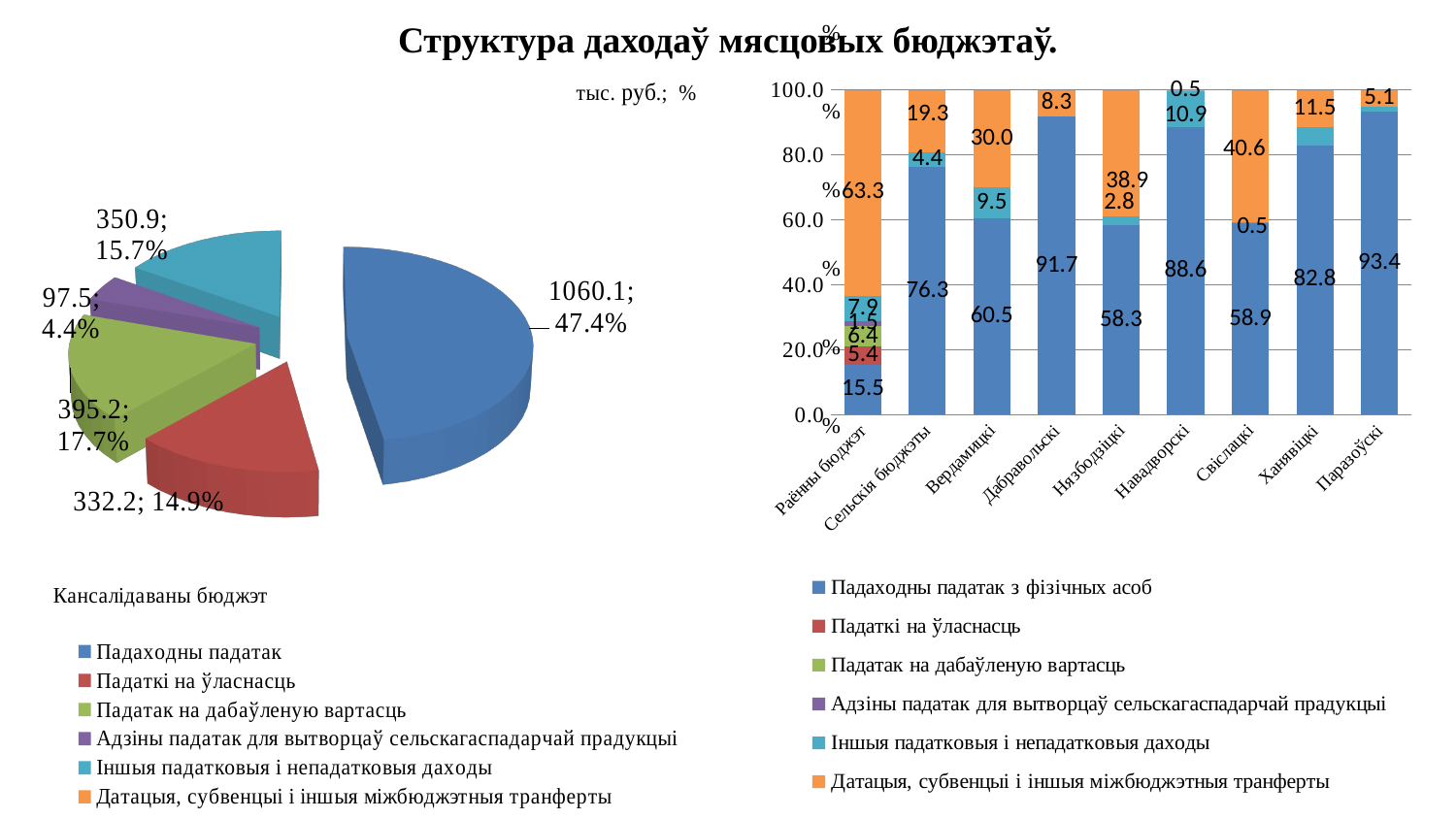
In the pie chart on the left, which slice is the smallest? Адзіны падатак для вытворцаў сельскагаспадарчай прадукцыі (97.5; 4.4%) In the stacked bar chart on the right, how many categories are shown on the x axis? 9 In the stacked bar chart on the right, what is the value of Датацыі, субвенцыі і іншыя міжбюджэтныя трансферты for Раённы бюджэт? 63.3 In the stacked bar chart on the right, what is the value of Падаходны падатак з фізічных асоб for Паразоўскі? 93.4 In the pie chart on the left, which is larger: the slice labelled 332.2 or the slice labelled 350.9? 350.9 What type of chart is shown on the right side of the slide? Stacked bar chart In the pie chart on the left, what value is shown for the blue slice (Падаходны падатак)? 1060.1; 47.4% In the pie chart on the left, which slice is the largest? Падаходны падатак (1060.1; 47.4%) In the stacked bar chart on the right, which category has the lowest value for Падаходны падатак з фізічных асоб? Раённы бюджэт In the stacked bar chart on the right, what is the difference between the Падаходны падатак з фізічных асоб values for Дабравольскі and Вердамицкі? 31.2 In the pie chart on the left, what share of the pie does the slice labelled 395.2 represent? 17.7% In the stacked bar chart on the right, how many series does the legend list? 6